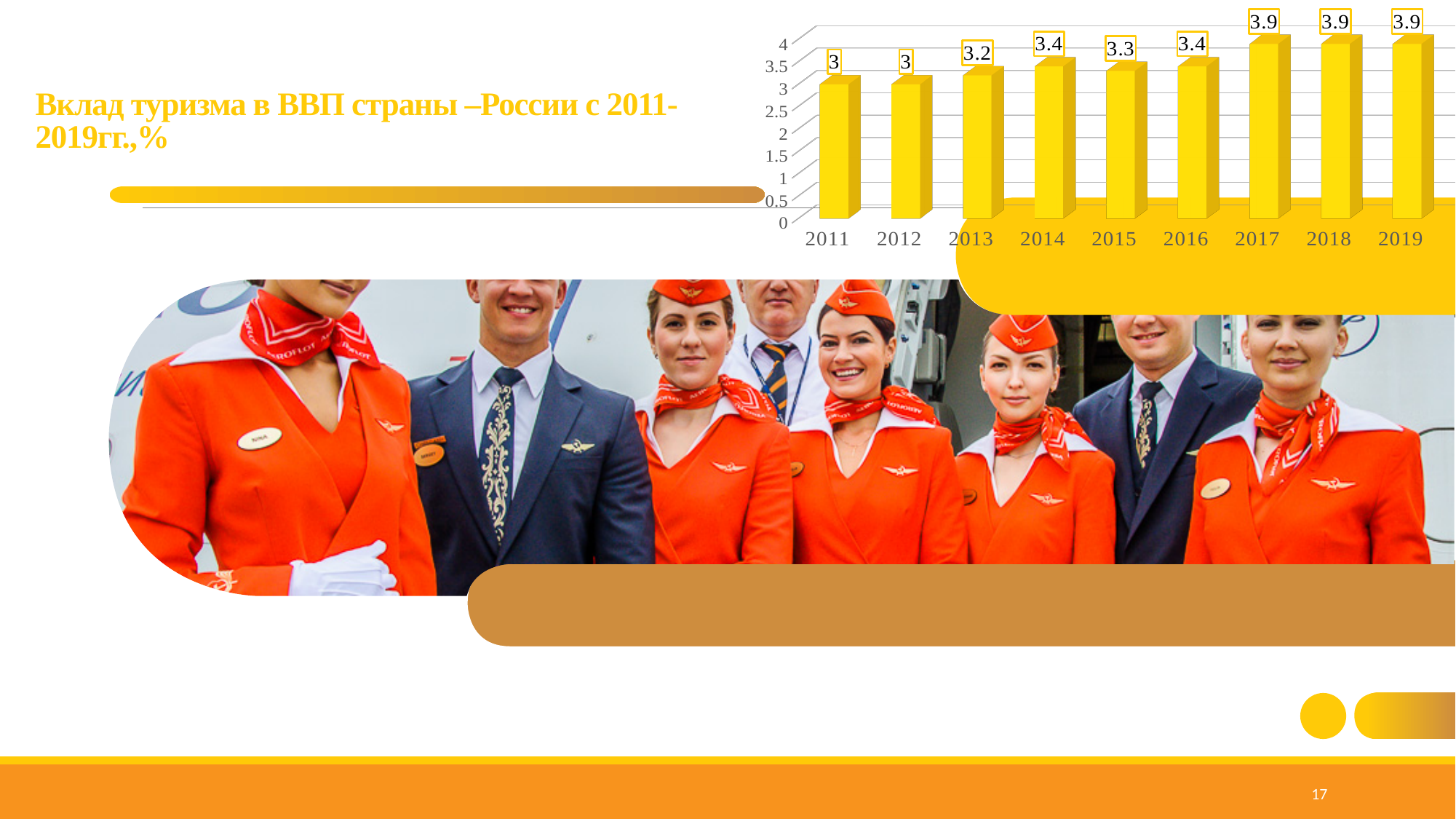
What kind of chart is shown on the slide? bar chart What is the value for 2013? 3.2 Which year has the lowest value? 2011 and 2012 What is the value for 2015? 3.3 Is the value for 2017 greater or less than 3.5? greater What is the difference between the values for 2019 and 2011? 0.9 Do the values generally rise or fall from 2011 to 2019? rise How many years are shown on the x axis? 9 What is the value for 2011? 3 What is the difference between the values for 2014 and 2013? 0.2 What is the value for 2019? 3.9 Which is larger, the value for 2014 or the value for 2015? 2014